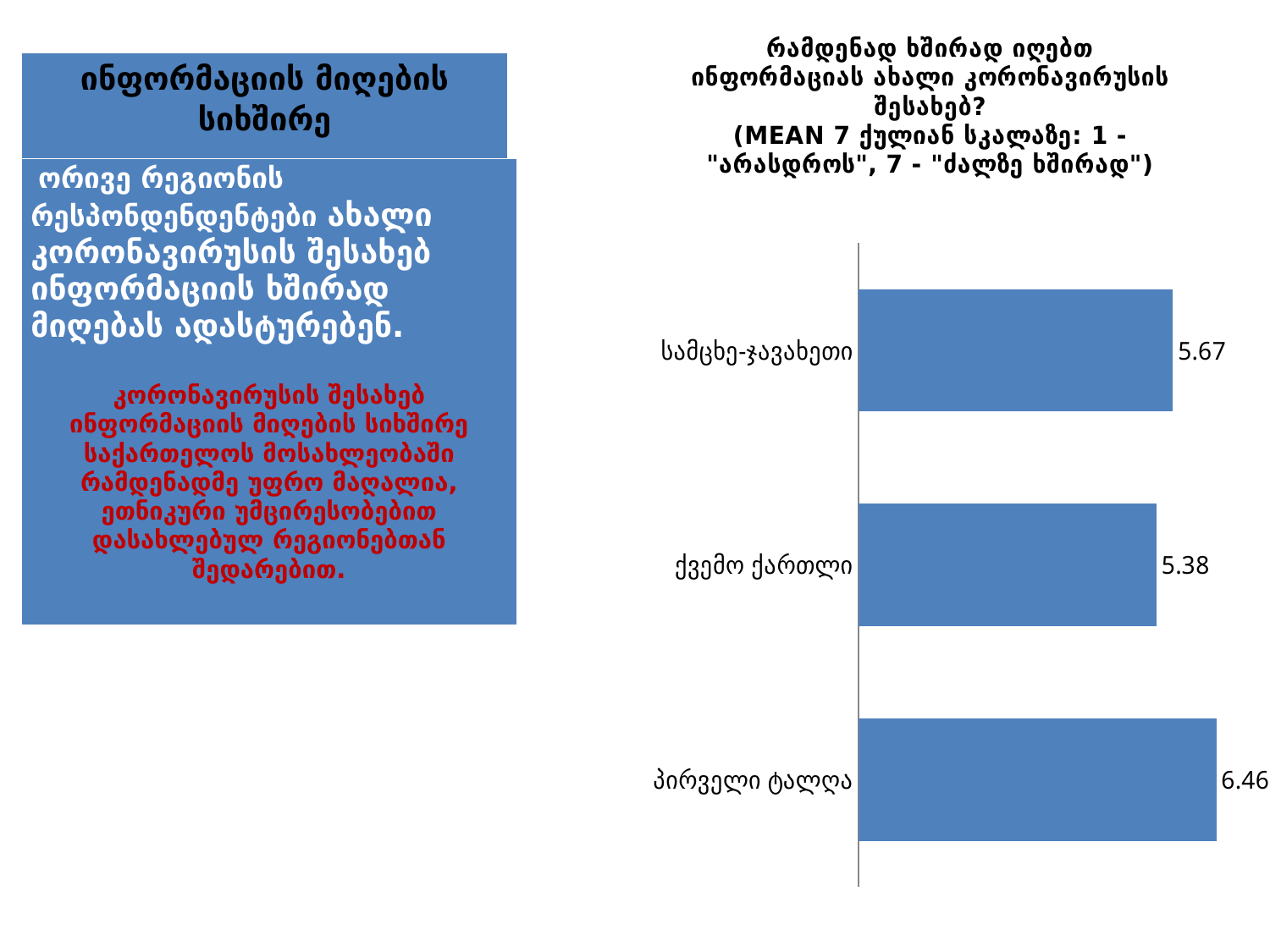
What is the difference between the values for სამცხე-ჯავახეთი and ქვემო ქართლი? 0.29 What colour are the bars in the chart? Blue How many categories are shown in the chart? 3 Which category has the highest value? პირველი ტალღა What kind of chart is shown on the slide? Bar chart Which is larger, the value for სამცხე-ჯავახეთი or the value for ქვემო ქართლი? სამცხე-ჯავახეთი What is the value for პირველი ტალღა? 6.46 According to the chart title, what scale is the mean measured on? 7-point scale (1 - "არასდროს", 7 - "ძალზე ხშირად") What is the difference between the values for პირველი ტალღა and ქვემო ქართლი? 1.08 Which category has the lowest value? ქვემო ქართლი What is the value for ქვემო ქართლი? 5.38 What is the value for სამცხე-ჯავახეთი? 5.67